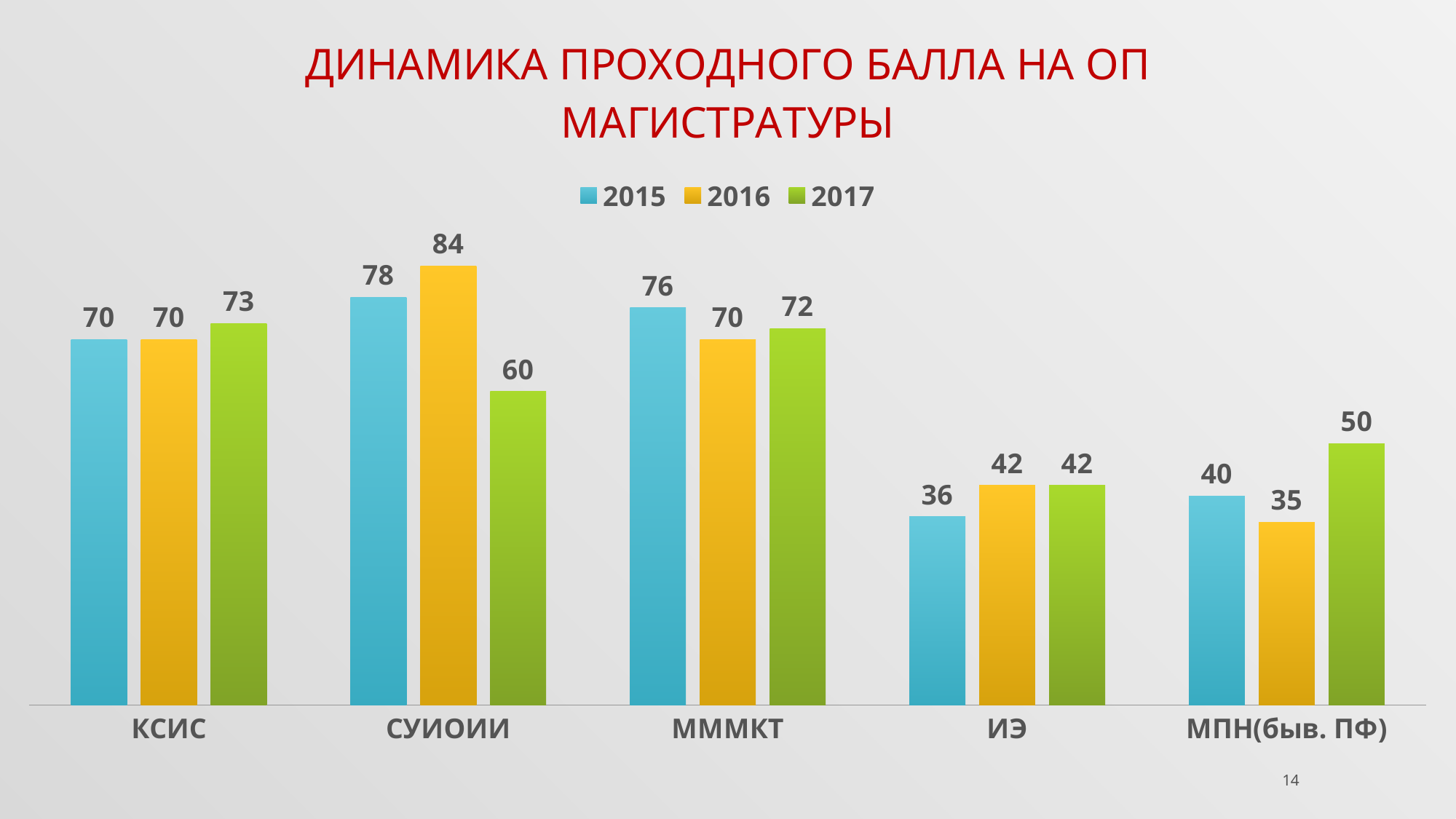
Do the values for ИЭ rise or fall from 2015 to 2016? Rise How many series does the legend list? 3 What is the value for МПН(быв. ПФ) in 2017? 50 Which category has the highest value in 2016? СУИОИИ Which category has the lowest value in 2015? ИЭ What is the difference between the 2016 and 2017 values for СУИОИИ? 24 What kind of chart is shown on the slide? Bar chart Which colour represents the 2017 series in the legend? Green What is the value for СУИОИИ in 2016? 84 What is the value for ИЭ in 2015? 36 Which is larger for МММКТ: the 2015 value or the 2017 value? 2015 How many categories are shown on the x axis? 5